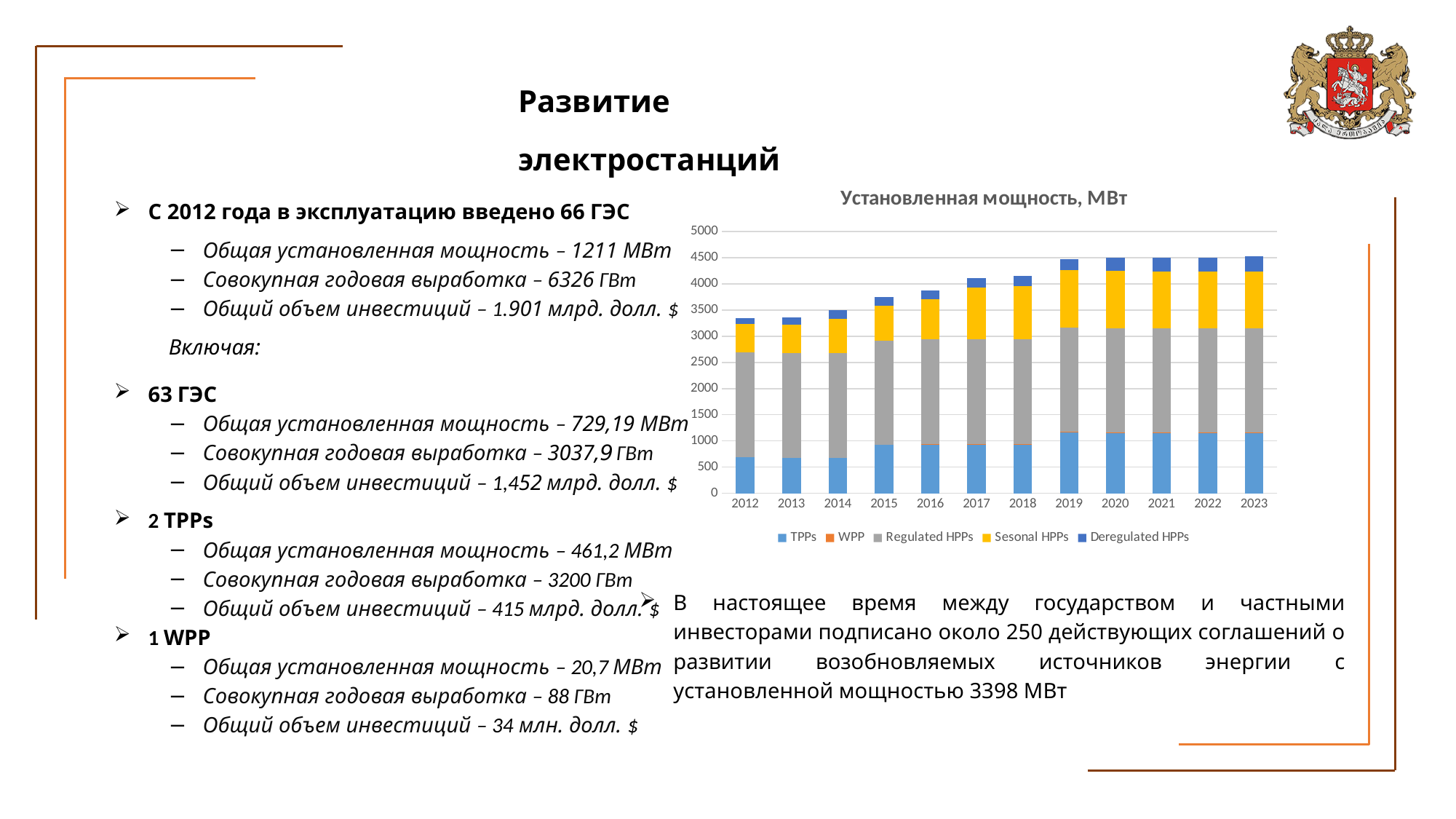
Is the TPPs value for 2019 greater or less than 1000? greater What is the title of the chart? Установленная мощность, МВт Which year has the larger total installed capacity, 2015 or 2018? 2018 Which series is shown in yellow in the chart? Sesonal HPPs How many years are shown on the x axis of the chart? 12 What kind of chart is shown on the slide? Stacked bar chart Is the total installed capacity for 2012 greater or less than 3500? less Is the total installed capacity for 2012 greater or less than 3000? greater How many series does the chart legend list? 5 Does the total installed capacity generally rise or fall from 2012 to 2023? rise